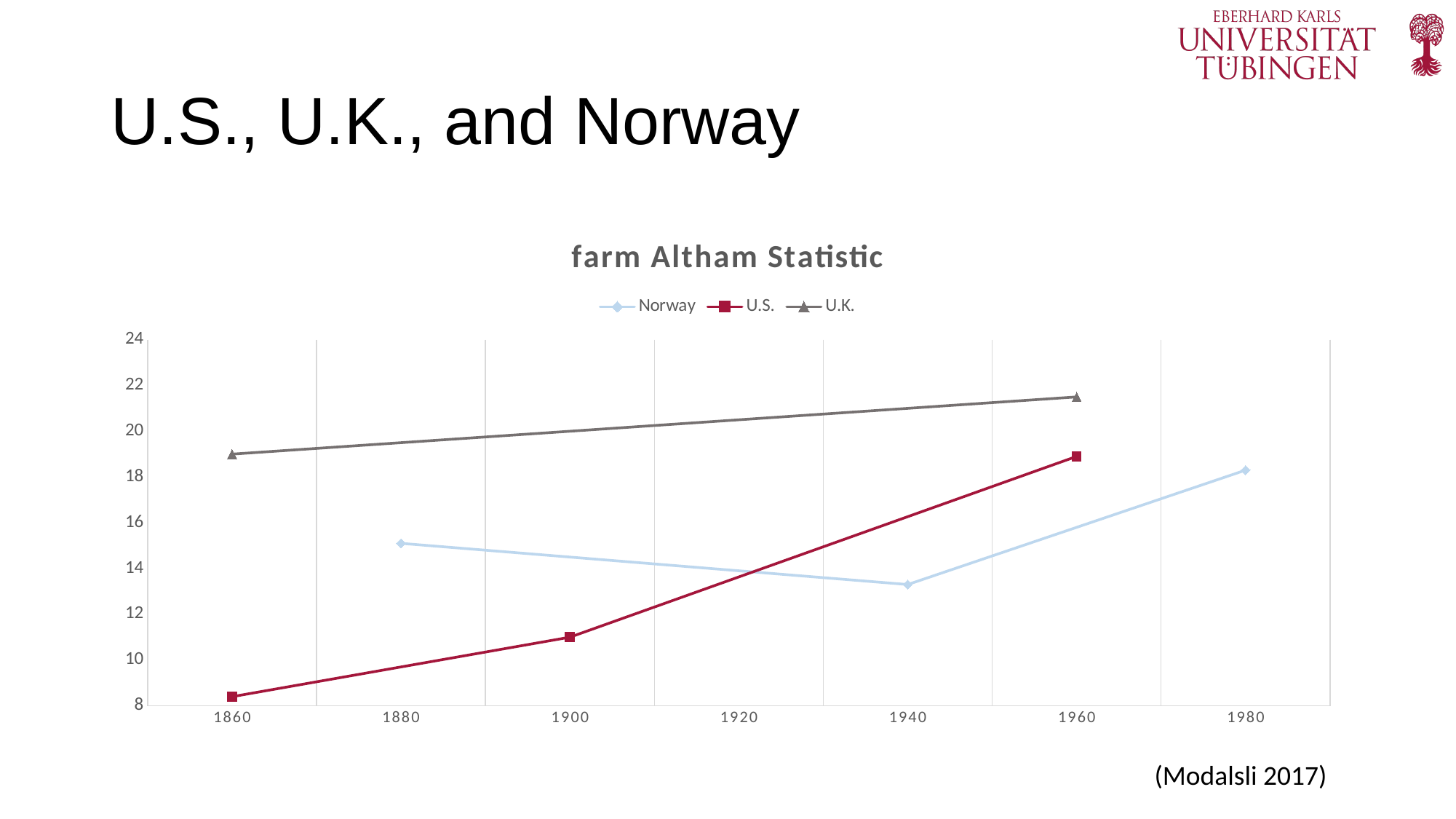
Is the value for the U.S. in 1860 greater or less than 10? less Which series has the highest value in 1960? U.K. What kind of chart is shown on the slide? line chart In 1960, which is larger: the U.K. value or the U.S. value? U.K. Does the U.K. line rise or fall from 1860 to 1960? rises Does the U.S. line rise or fall from 1860 to 1960? rises Is the value for Norway in 1940 greater or less than 14? less Is the value for the U.K. in 1960 greater or less than 20? greater How many series does the legend list? 3 Which series has the lowest plotted value on the chart? U.S. How many data points are plotted for the U.S. series? 3 What is the title of the chart? farm Altham Statistic